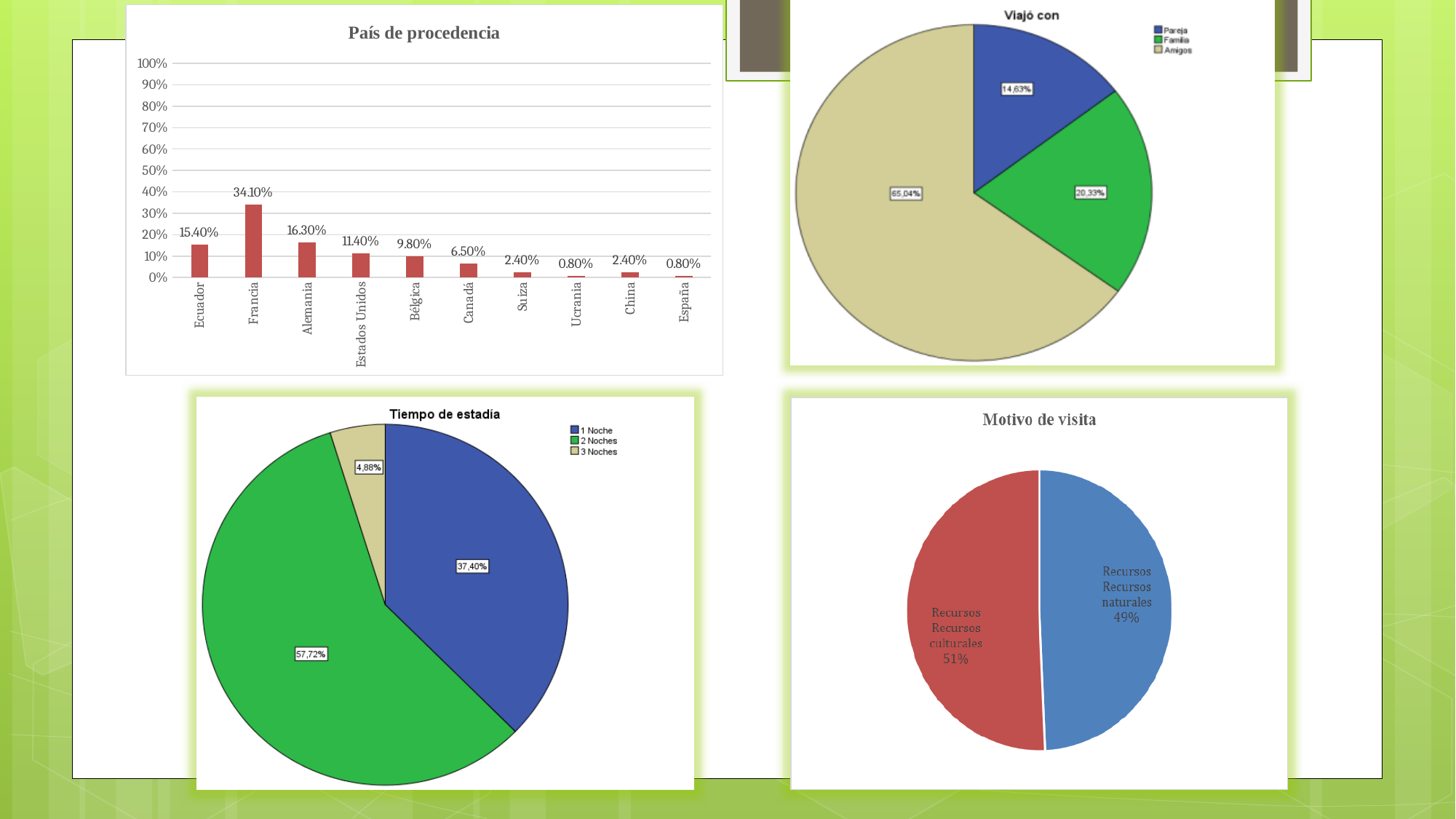
In the 'País de procedencia' chart, what is the difference between the values for Alemania and Ecuador? 0.90% In the 'Viajó con' pie chart, which category has the smallest share? Pareja How many countries are shown in the 'País de procedencia' chart? 10 In the 'Motivo de visita' pie chart, what share is labelled for Recursos culturales? 51% What kind of chart is 'Motivo de visita'? Pie chart How many entries does the legend of the 'Tiempo de estadía' chart list? 3 In the 'País de procedencia' chart, which is larger, the value for Estados Unidos or the value for Bélgica? Estados Unidos What kind of chart is 'País de procedencia'? Bar chart In the 'País de procedencia' chart, which country has the highest value? Francia In the 'País de procedencia' chart, what is the value for Francia? 34.10% In the 'Viajó con' pie chart, what share is labelled for Amigos? 65,04% In the 'Tiempo de estadía' pie chart, what share is labelled for 2 Noches? 57,72%